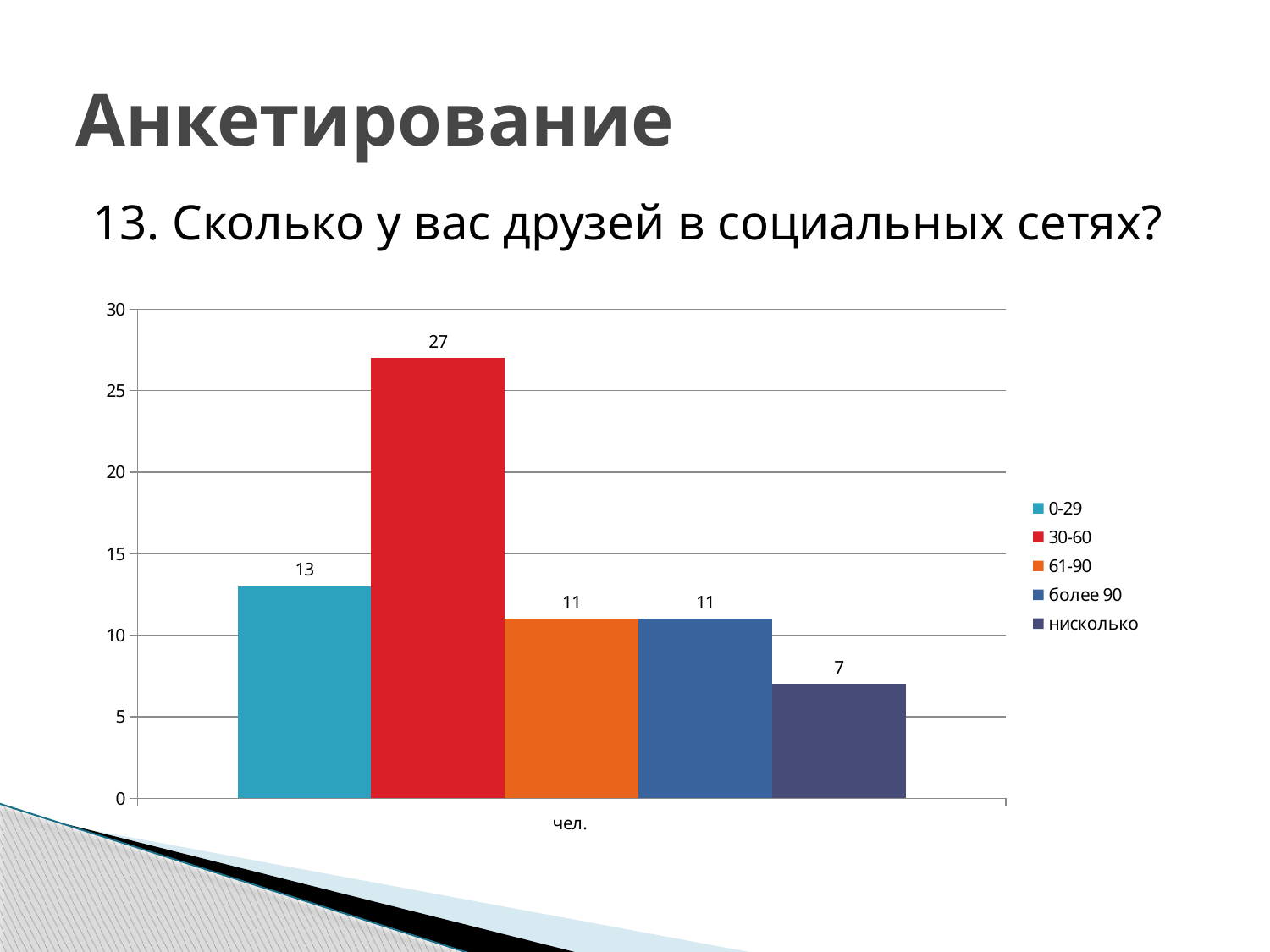
What is the value for the "30-60" series? 27 Which is larger, the value for "0-29" or the value for "61-90"? 0-29 What is the value for the "нисколько" series? 7 Which series has the highest value? 30-60 What is the label shown on the x axis of the chart? чел. What is the value for the "0-29" series? 13 Which series has the lowest value? нисколько What is the difference between the values for "30-60" and "0-29"? 14 Is the value for "30-60" greater or less than 25? greater How many series does the legend list? 5 What kind of chart is shown on the slide? bar chart What is the value for the "более 90" series? 11